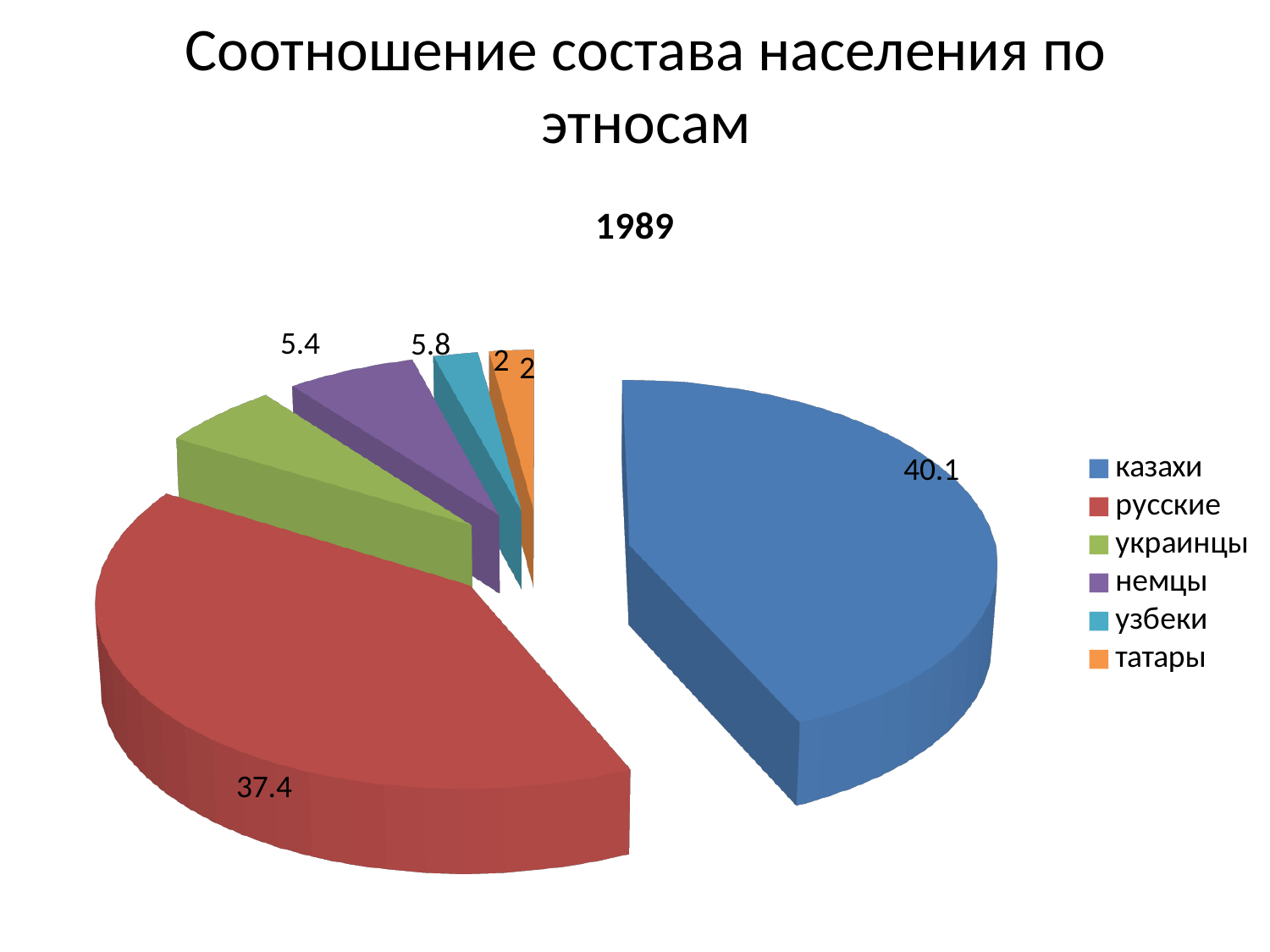
What value is shown for немцы? 5.8 How many slices does the pie chart have? 6 What is the difference between the values for казахи and русские? 2.7 What kind of chart is shown on the slide? pie chart Which is larger, the value for немцы or the value for украинцы? немцы What value is shown for украинцы? 5.4 What is the title shown above the pie chart? 1989 What value is shown for русские? 37.4 What is the difference between the values for немцы and украинцы? 0.4 What value is shown for казахи? 40.1 Which category has the largest slice of the pie? казахи What value is shown for узбеки? 2